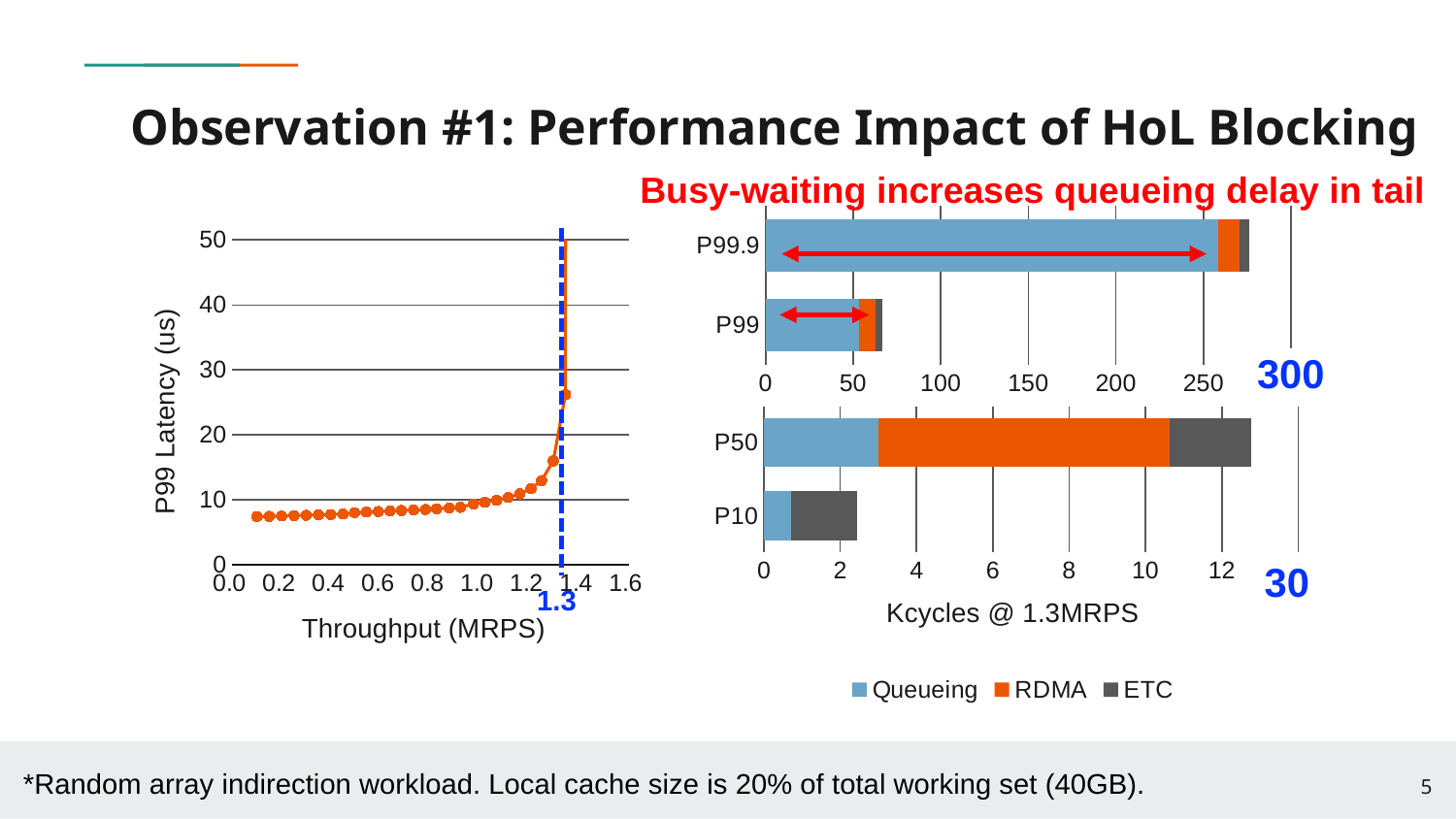
What is the x-axis title of the lower right bar chart? Kcycles @ 1.3MRPS In the lower right bar chart (P50 and P10), is the total for P50 greater or less than 12? greater How many series does the legend of the right-hand bar charts list? 3 What type of chart is used on the right side of the slide for the P99.9, P99, P50 and P10 breakdowns? bar chart What type of chart is the left chart showing P99 Latency against Throughput? line chart In the upper right bar chart, is the total for P99 greater or less than 100? less In the lower right bar chart, is the total for P10 greater or less than 4? less In the upper right bar chart (P99.9 and P99), which category has the longer total bar? P99.9 In the left chart, does P99 latency rise or fall as throughput increases along the x axis? rise In the left chart, what throughput value is marked by the blue dashed vertical line? 1.3